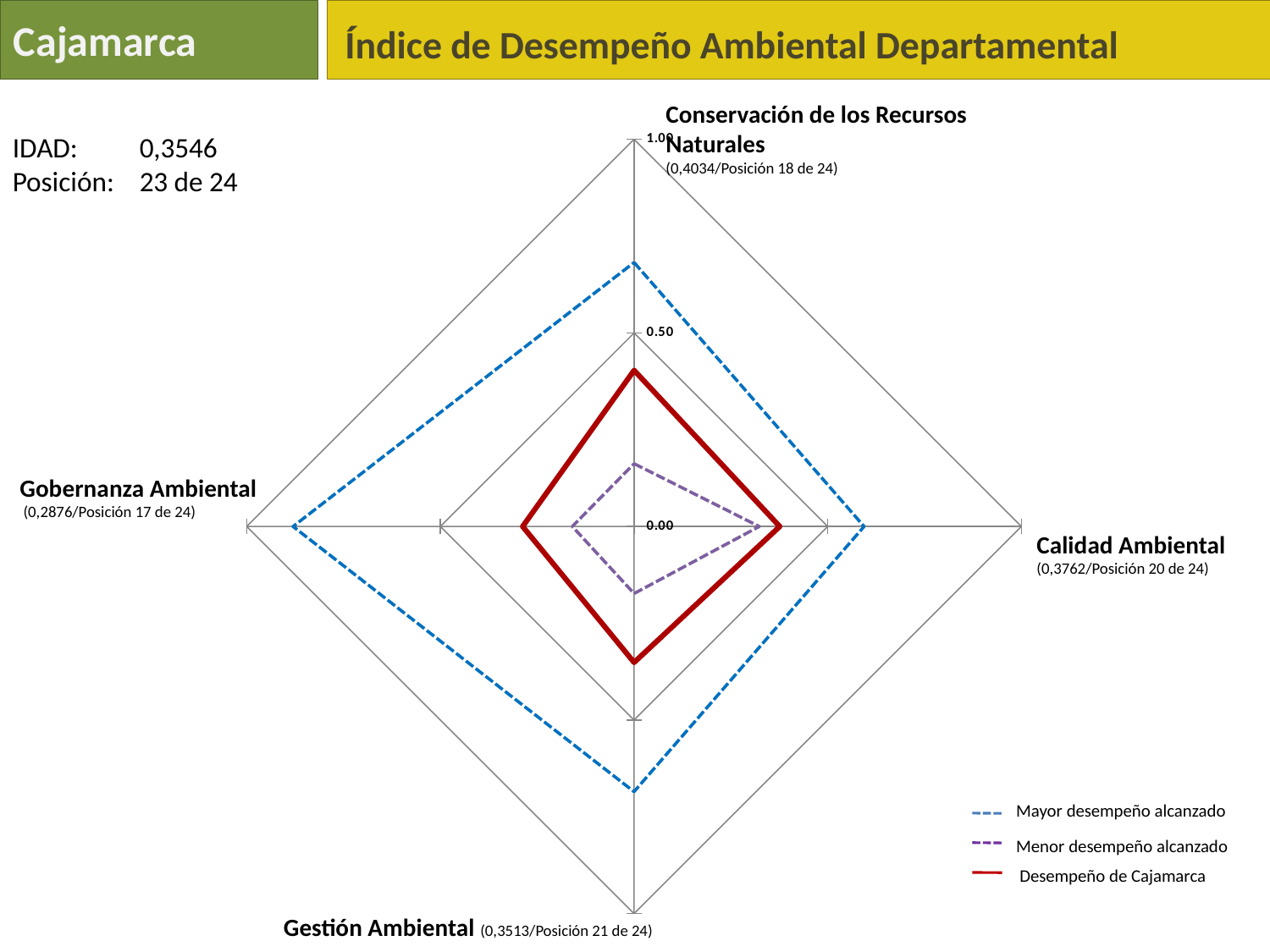
What is Cajamarca's value for Calidad Ambiental? 0,3762 What is Cajamarca's value for Conservación de los Recursos Naturales? 0,4034 What is Cajamarca's value for Gobernanza Ambiental? 0,2876 What is the difference between Cajamarca's values for Conservación de los Recursos Naturales and Gobernanza Ambiental? 0,1158 What is Cajamarca's value for Gestión Ambiental? 0,3513 Is the value of the 'Mayor desempeño alcanzado' series on the Gobernanza Ambiental axis greater or less than 0.50? greater What type of chart is shown on the slide? Radar chart Which series is drawn as a solid red line? Desempeño de Cajamarca On which axis does Cajamarca have its lowest value? Gobernanza Ambiental How many axes (categories) does the radar chart have? 4 On which axis does Cajamarca have its highest value? Conservación de los Recursos Naturales How many series does the legend list? 3